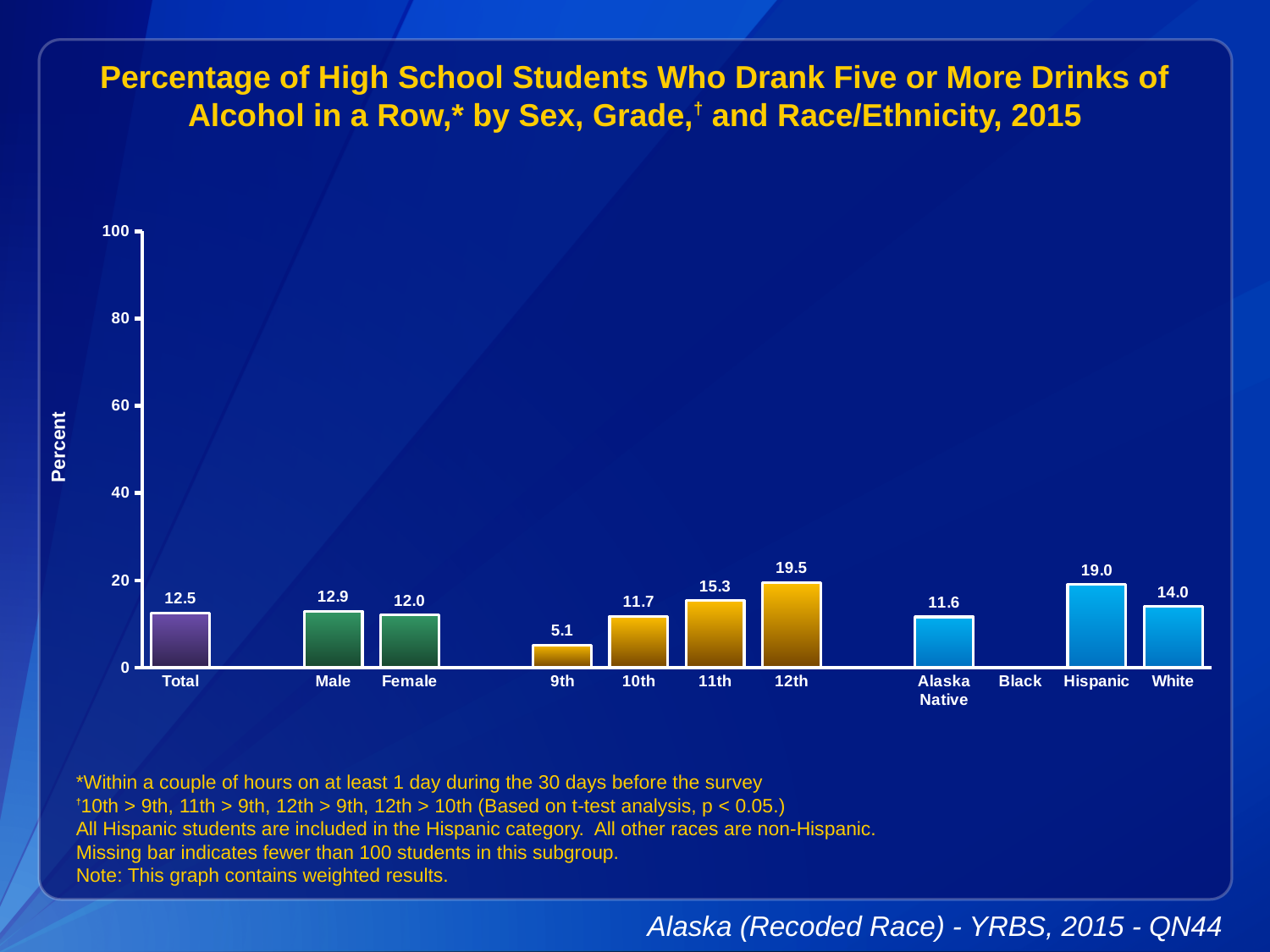
How many bars are plotted on the chart? 10 What is the value for Hispanic students? 19.0 What is the difference between the values for 12th and 9th grade? 14.4 Which is larger, the value for Hispanic or the value for White? Hispanic Is the value for 11th grade greater or less than 20? less Which category has the highest value? 12th What kind of chart is shown? bar chart What is the value for Total? 12.5 Which category has the lowest value among the plotted bars? 9th What is the difference between the values for Male and Female? 0.9 Do the values rise or fall from 9th grade to 12th grade? rise What is the value for 9th grade students? 5.1